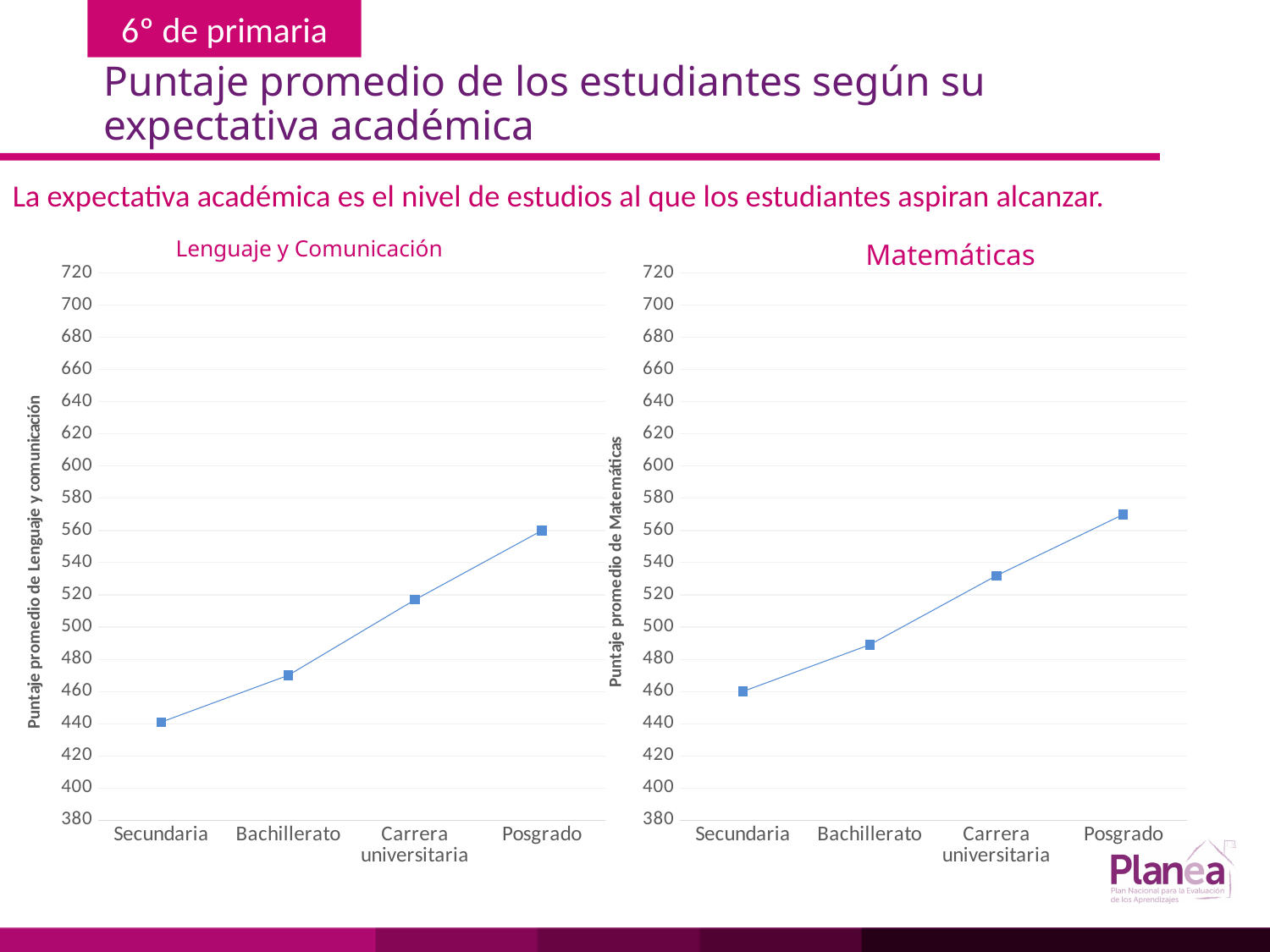
In the Lenguaje y Comunicación chart, do the values rise or fall from Secundaria to Posgrado? rise How many categories are shown on the x axis of the Matemáticas chart? 4 In the Matemáticas chart, which category has the highest value? Posgrado In the Matemáticas chart, is the value for Posgrado greater or less than 560? greater In the Lenguaje y Comunicación chart, is the value for Secundaria greater or less than 460? less What is the y-axis label of the chart on the left side of the slide? Puntaje promedio de Lenguaje y comunicación In the Matemáticas chart, is the value for Carrera universitaria greater or less than 520? greater What is the title of the chart on the right side of the slide? Matemáticas In the Lenguaje y Comunicación chart, which category has the lowest value? Secundaria What kind of chart is the Lenguaje y Comunicación chart? line chart In the Lenguaje y Comunicación chart, which is larger, the value for Bachillerato or the value for Carrera universitaria? Carrera universitaria